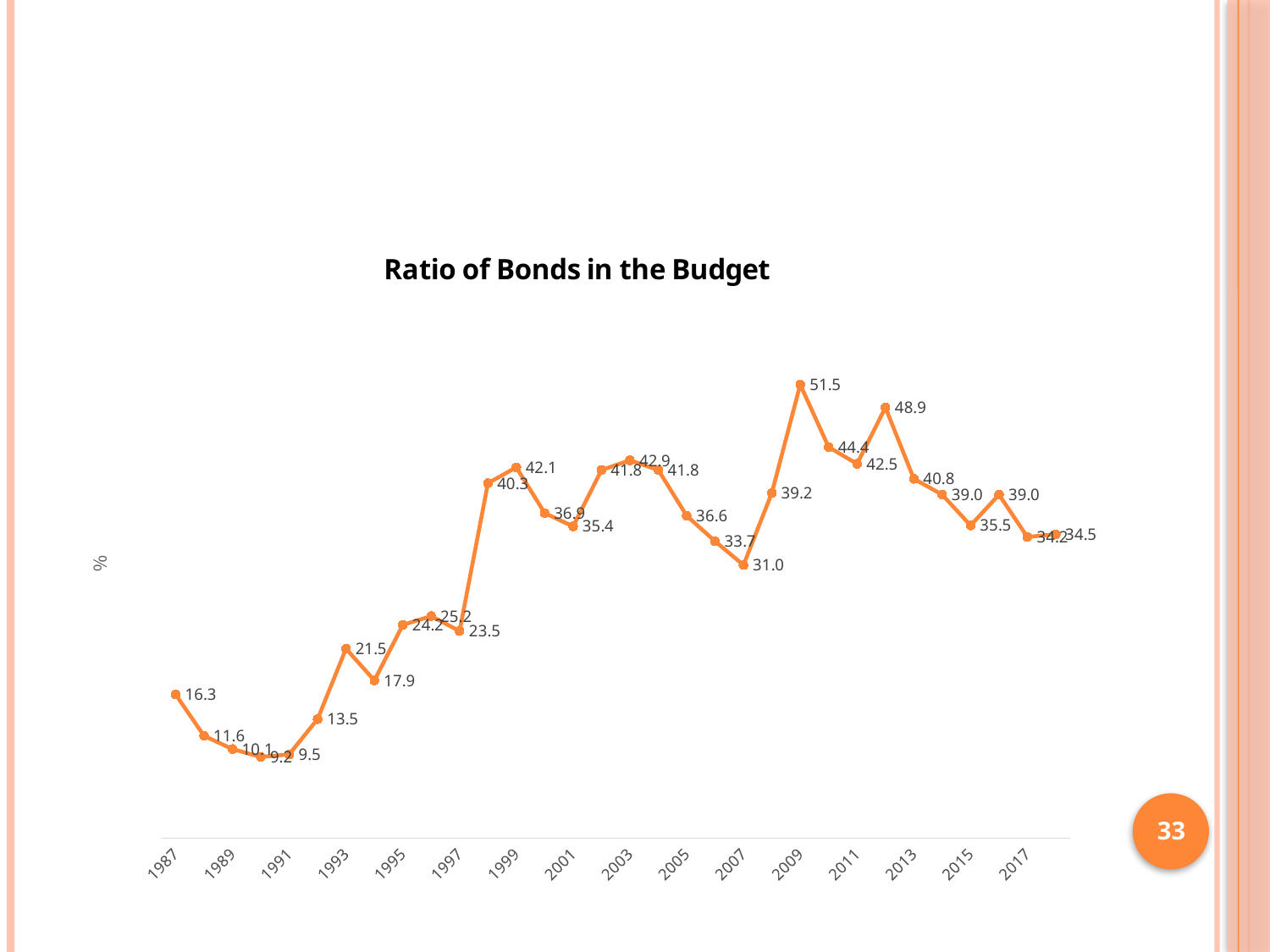
What unit is shown on the vertical axis label? % What type of chart is shown on the slide? line chart What is the value for 2009? 51.5 What is the title of the chart? Ratio of Bonds in the Budget Which is larger, the value for 1993 or the value for 1995? 1995 What is the value for 2017? 34.2 Which year has the highest value? 2009 What is the value for 2007? 31.0 What is the value for 1987? 16.3 Does the value rise or fall from 1987 to 1991? fall What is the difference between the values for 2009 and 2007? 20.5 What is the lowest value plotted on the chart? 9.2